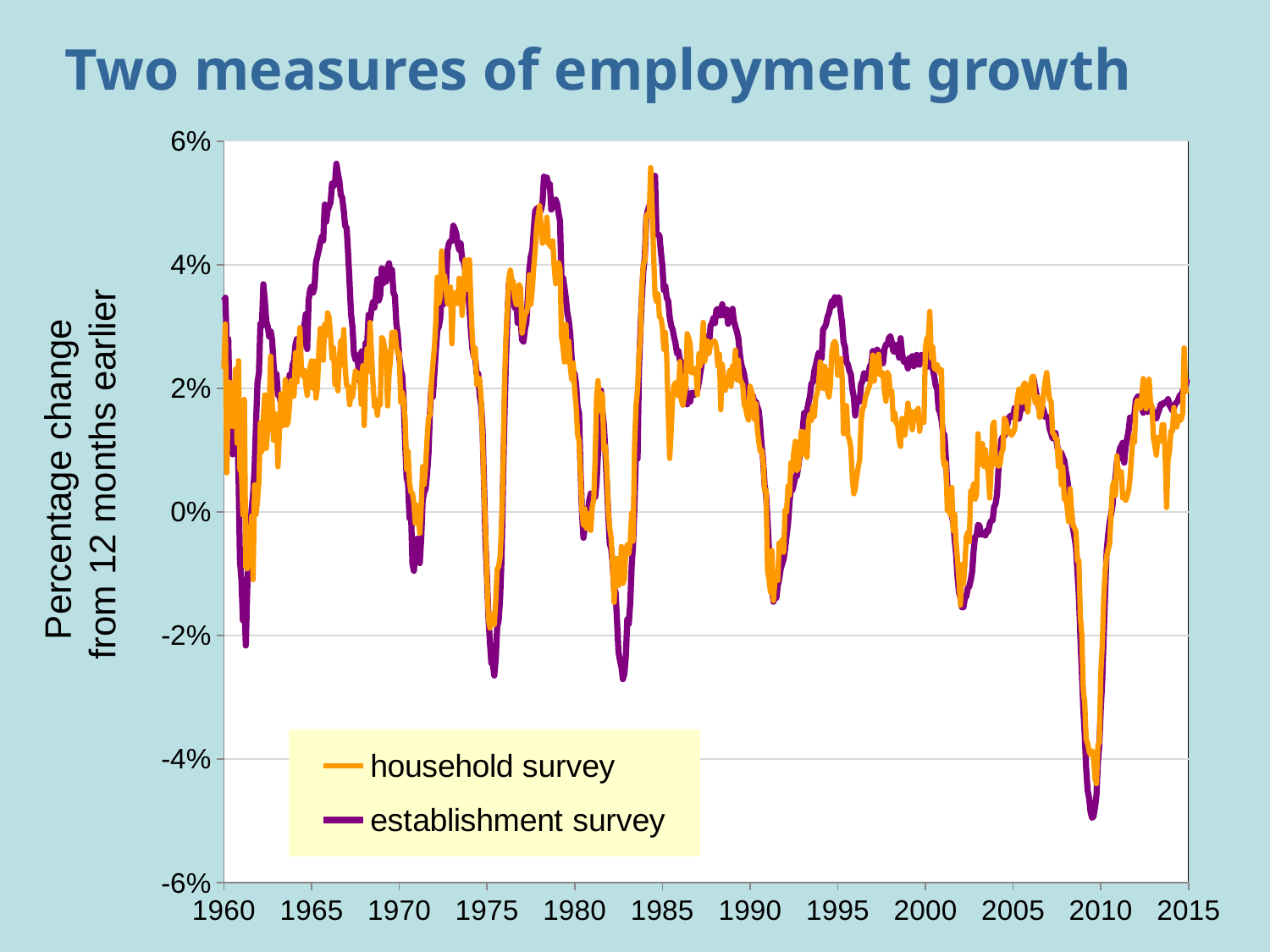
What is the title of the chart? Two measures of employment growth Around which year does the establishment survey reach its lowest value? 2010 How many series does the legend list? 2 Which colour is used for the establishment survey line? purple Is the establishment survey value at its peak around 1966 greater or less than 4%? greater Is the establishment survey value at its trough around 2010 greater or less than -4%? less Is the household survey value around 1966 greater or less than 4%? less At the trough around 2010, which series falls lower, the household survey or the establishment survey? establishment survey Around 1966, which series shows the higher value, the household survey or the establishment survey? establishment survey What kind of chart is shown on the slide? line chart